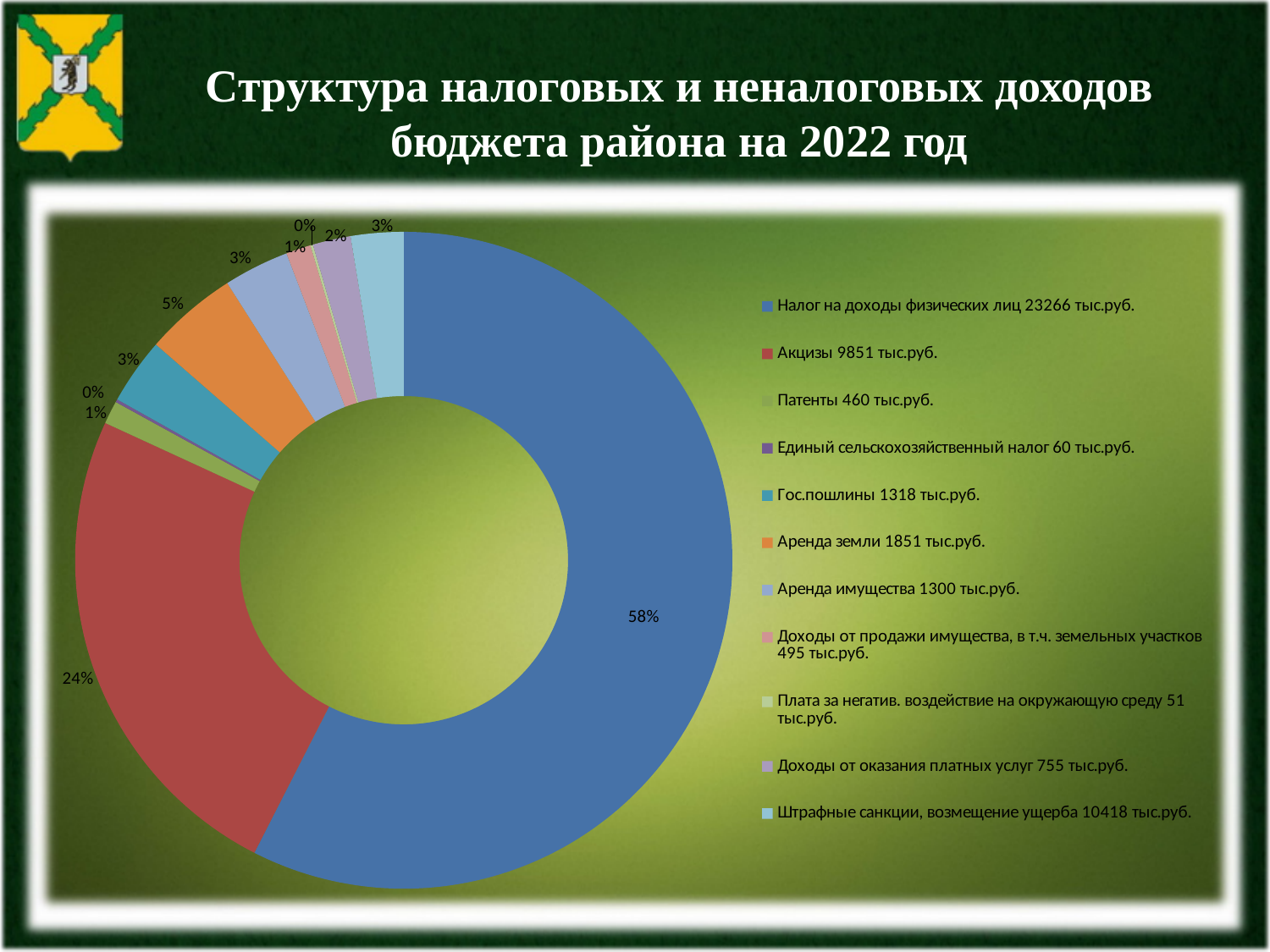
According to the legend, what is the amount for 'Единый сельскохозяйственный налог'? 60 тыс.руб. Which category has the largest slice in the chart? Налог на доходы физических лиц According to the legend, what is the amount for 'Аренда имущества'? 1300 тыс.руб. How many categories does the legend of the chart list? 11 What share of the chart does 'Налог на доходы физических лиц' take? 58% By how many percentage points does the share of 'Налог на доходы физических лиц' exceed the share of 'Акцизы'? 34 percentage points According to the legend, what is the amount for 'Гос.пошлины'? 1318 тыс.руб. What colour is the slice for 'Акцизы'? Red What share of the chart does 'Акцизы' take? 24% Which is larger: the slice for 'Акцизы' or the slice for 'Аренда земли'? Акцизы What kind of chart is shown on the slide? Doughnut (pie) chart What share of the chart does 'Аренда земли' take? 5%